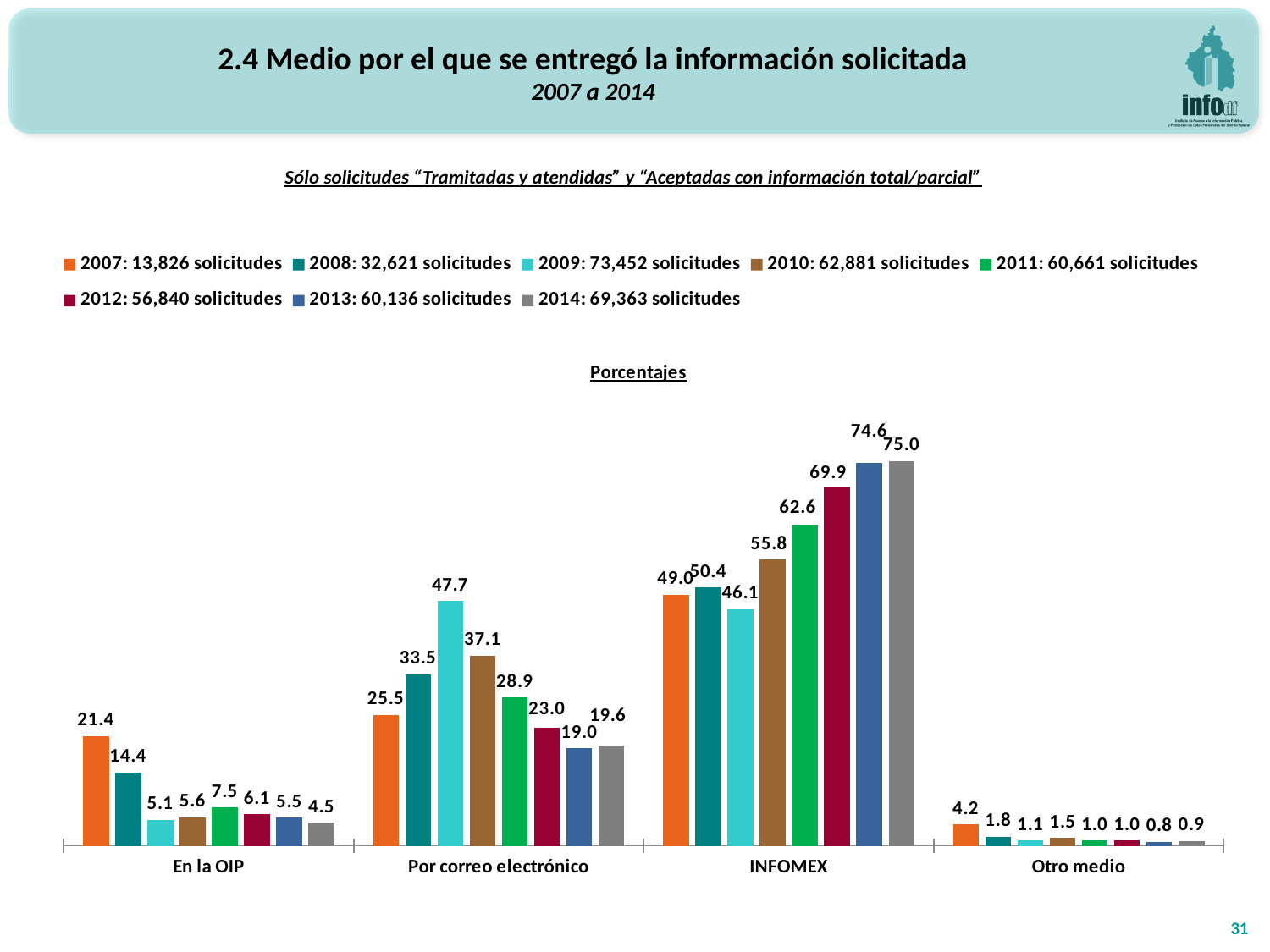
How many series does the legend list? 8 What is the value for 2007 in the 'En la OIP' category? 21.4 Which is larger in the 'En la OIP' category: the value for 2008 or the value for 2011? 2008 What is the difference between the 2014 and 2007 values in the 'INFOMEX' category? 26.0 Do the values for 'INFOMEX' generally rise or fall from 2010 to 2014? Rise How many categories are shown on the x axis? 4 What is the value for 2009 in the 'Por correo electrónico' category? 47.7 Which year has the highest value in the 'Por correo electrónico' category? 2009 What is the value for 2014 in the 'INFOMEX' category? 75.0 According to the legend, how many solicitudes were there in 2009? 73,452 What type of chart is shown on the slide? Bar chart Which year has the lowest value in the 'Otro medio' category? 2013